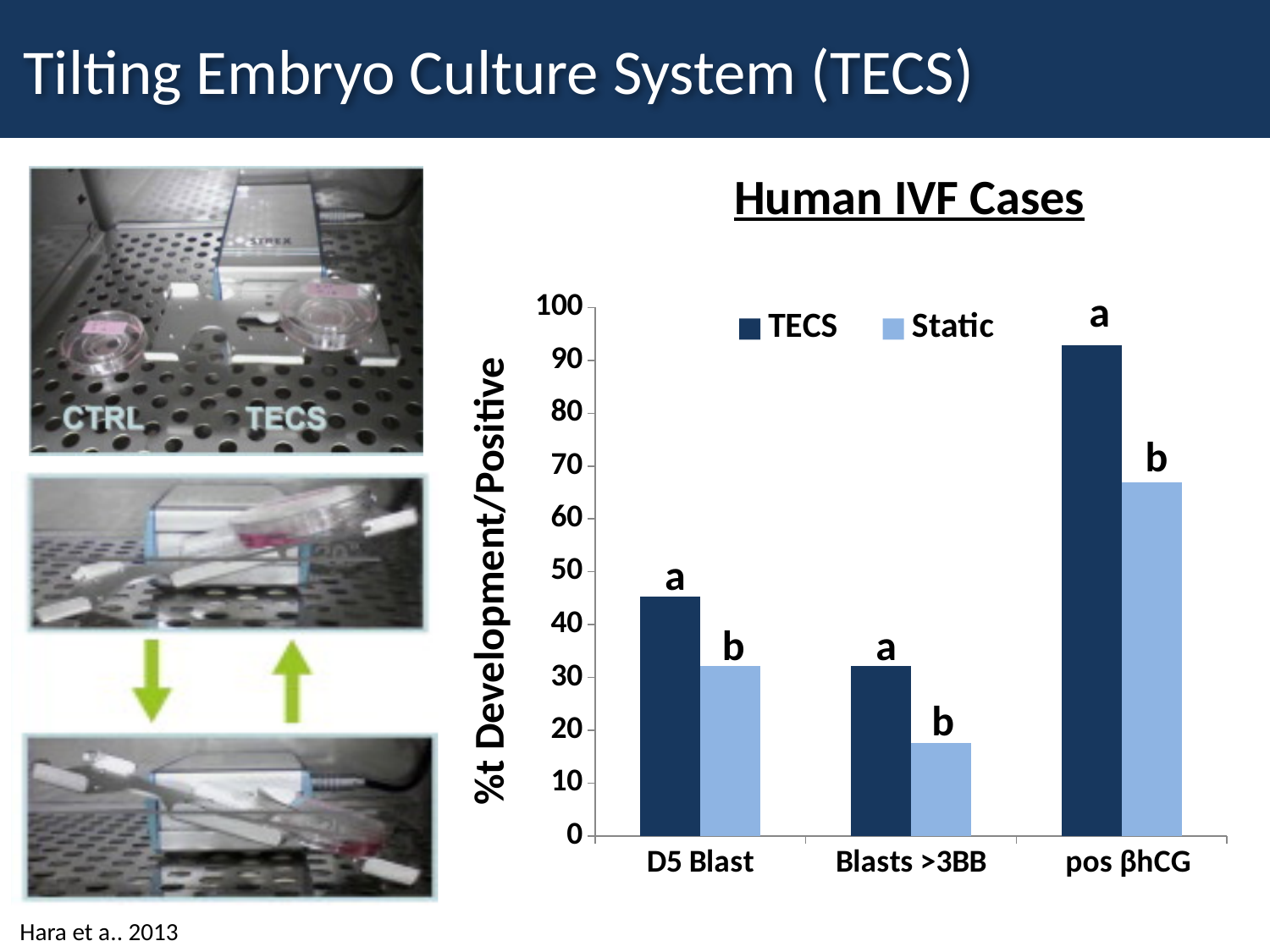
What is the y-axis label of the Human IVF Cases chart? %t Development/Positive Which series is shown in dark blue in the Human IVF Cases chart? TECS In the Human IVF Cases chart, which is larger for D5 Blast: the TECS value or the Static value? TECS In the Human IVF Cases chart, is the Static value for Blasts >3BB greater or less than 20? less In the Human IVF Cases chart, is the Static value for pos βhCG greater or less than 70? less In the Human IVF Cases chart, is the TECS value for D5 Blast greater or less than 40? greater How many categories are shown on the x axis of the Human IVF Cases chart? 3 How many series does the legend of the Human IVF Cases chart list? 2 Which category has the highest TECS value in the Human IVF Cases chart? pos βhCG Which category has the lowest Static value in the Human IVF Cases chart? Blasts >3BB What kind of chart is shown under the heading Human IVF Cases? bar chart